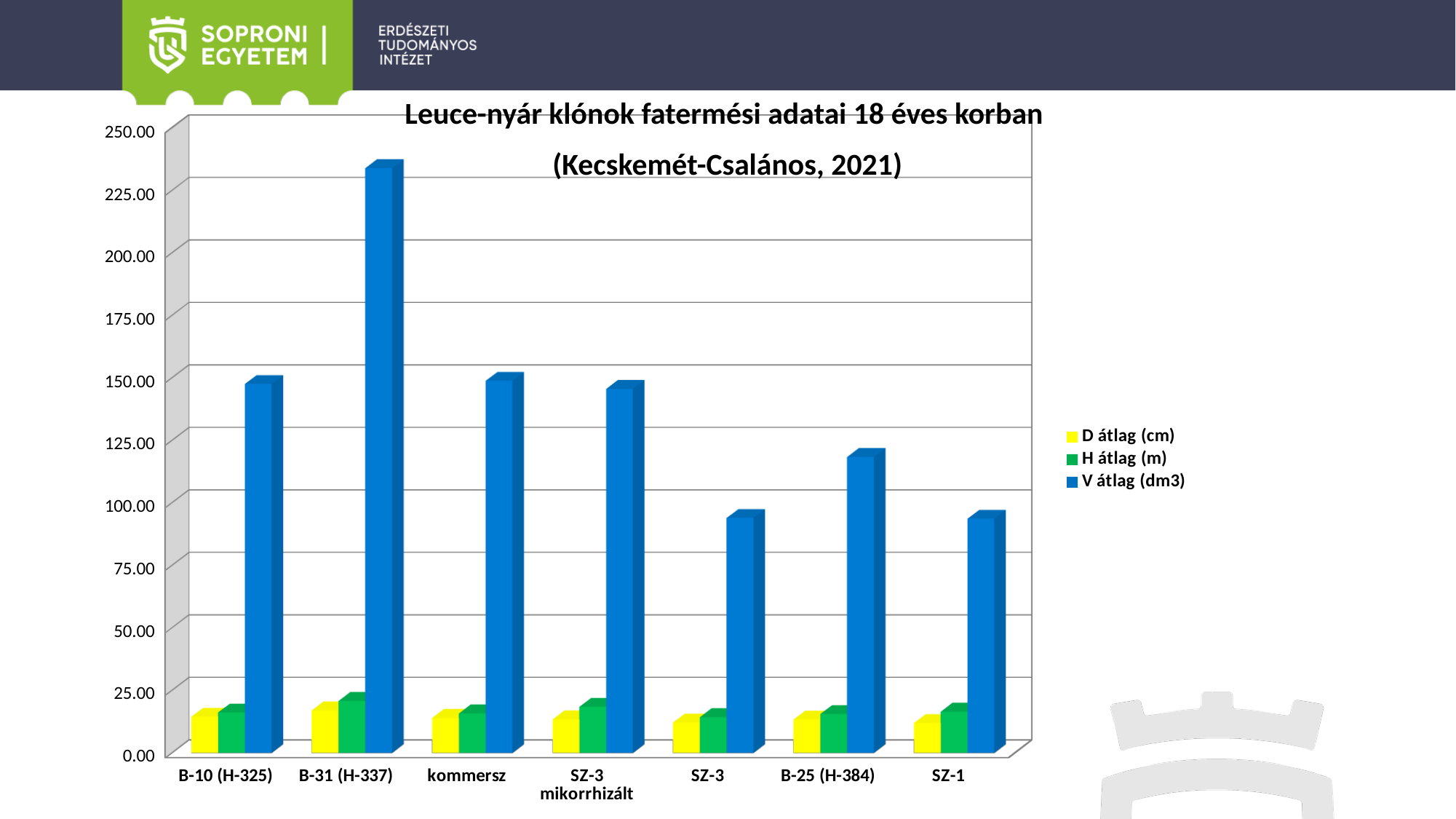
What is the title of the chart? Leuce-nyár klónok fatermési adatai 18 éves korban (Kecskemét-Csalános, 2021) Is the V átlag (dm3) value for SZ-3 greater or less than 100? less Is the V átlag (dm3) value for kommersz greater or less than 125? greater Which category has the highest V átlag (dm3) value? B-31 (H-337) Is the V átlag (dm3) value for B-31 (H-337) greater or less than 200? greater Which has a larger V átlag (dm3) value, SZ-3 or B-25 (H-384)? B-25 (H-384) How many clone categories are shown on the x axis? 7 Which has a larger V átlag (dm3) value, B-31 (H-337) or B-25 (H-384)? B-31 (H-337) What kind of chart is shown on the slide? bar chart Which series is shown in blue in the legend? V átlag (dm3) How many series does the legend list? 3